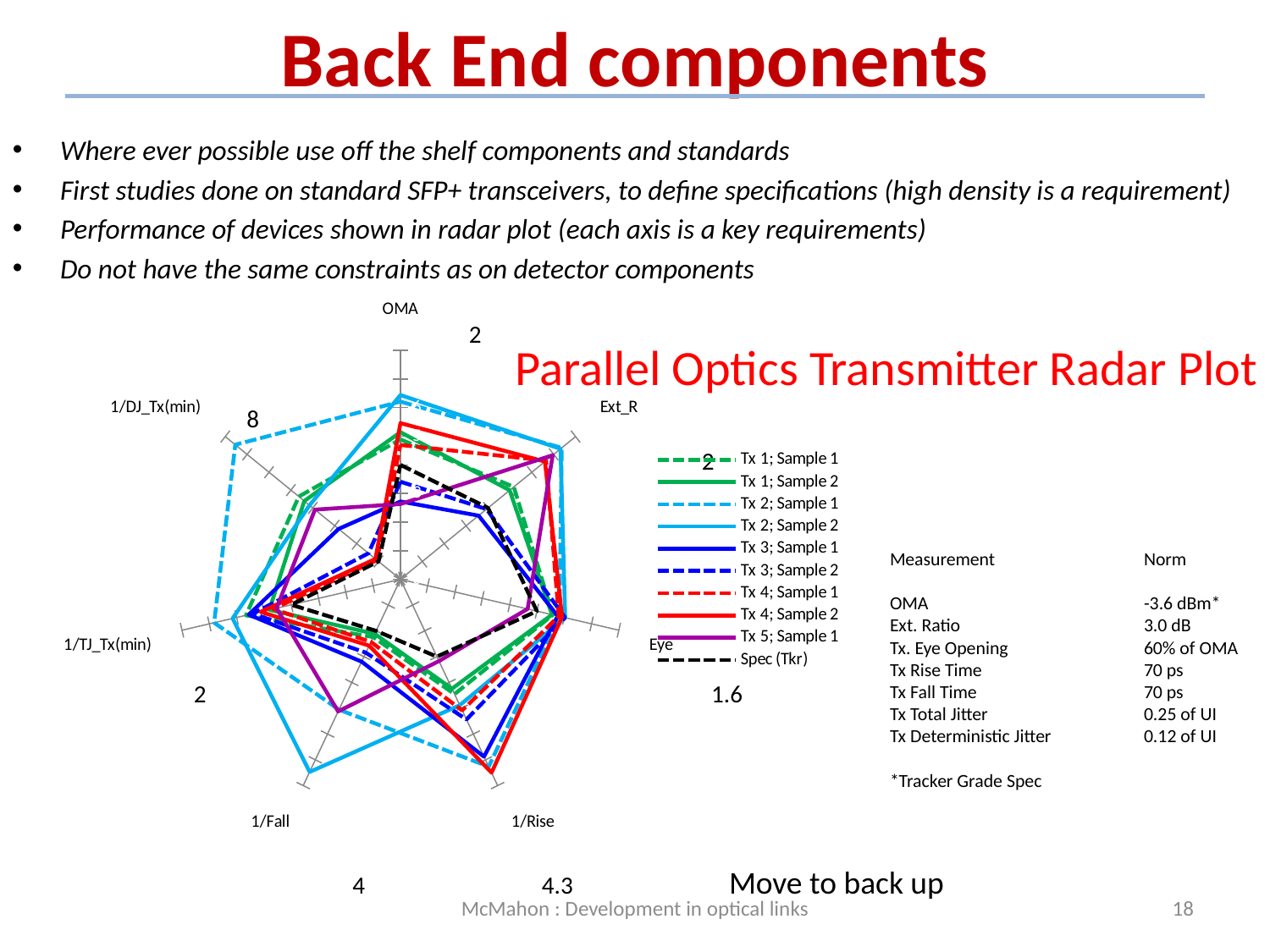
How many samples of Tx 5 are plotted on the radar chart? 1 What is the label of the axis at the top of the radar chart? OMA Which series reaches furthest out along the OMA axis? Tx 2; Sample 2 Which legend entry is drawn as a black dashed line? Spec (Tkr) How many series does the legend of the radar chart list? 10 Which series reaches furthest out along the 1/Fall axis? Tx 2; Sample 2 Which series reaches furthest out along the 1/Rise axis? Tx 4; Sample 2 How many axes (key requirements) does the radar chart have? 7 What kind of chart is shown on the slide? Radar chart What is the title of the radar chart? Parallel Optics Transmitter Radar Plot